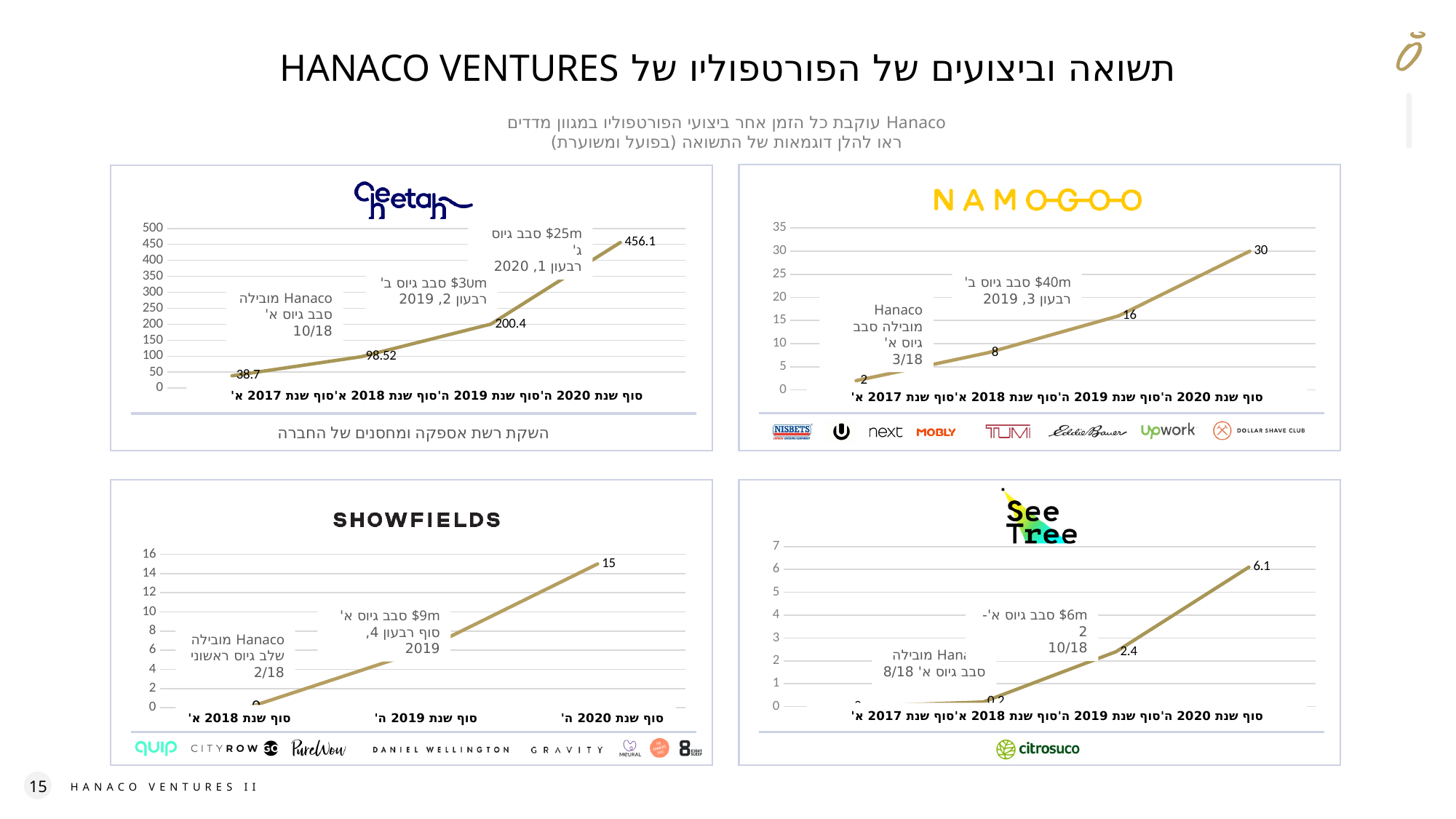
In the Cheetah chart (top left), what is the difference between the end of 2019 value and the end of 2017 value? 161.7 In the Showfields chart (bottom left), is the value at the end of 2019 greater or less than 8? less In the SeeTree chart (bottom right), do the values rise or fall from the end of 2017 to the end of 2020? rise In the Cheetah chart (top left), what is the value at the end of 2020? 456.1 What type of chart is the Namogoo chart (top right)? Line chart In the Cheetah chart (top left), what is the value at the end of 2018? 98.52 How many data points are plotted in the Showfields chart (bottom left)? 3 In the Namogoo chart (top right), what is the difference between the end of 2020 value and the end of 2019 value? 14 In the Namogoo chart (top right), which point has the lowest value? End of 2017 (סוף שנת 2017) In the SeeTree chart (bottom right), what is the value at the end of 2019? 2.4 In the Showfields chart (bottom left), what is the value at the end of 2020? 15 In the Namogoo chart (top right), what is the value at the end of 2020? 30